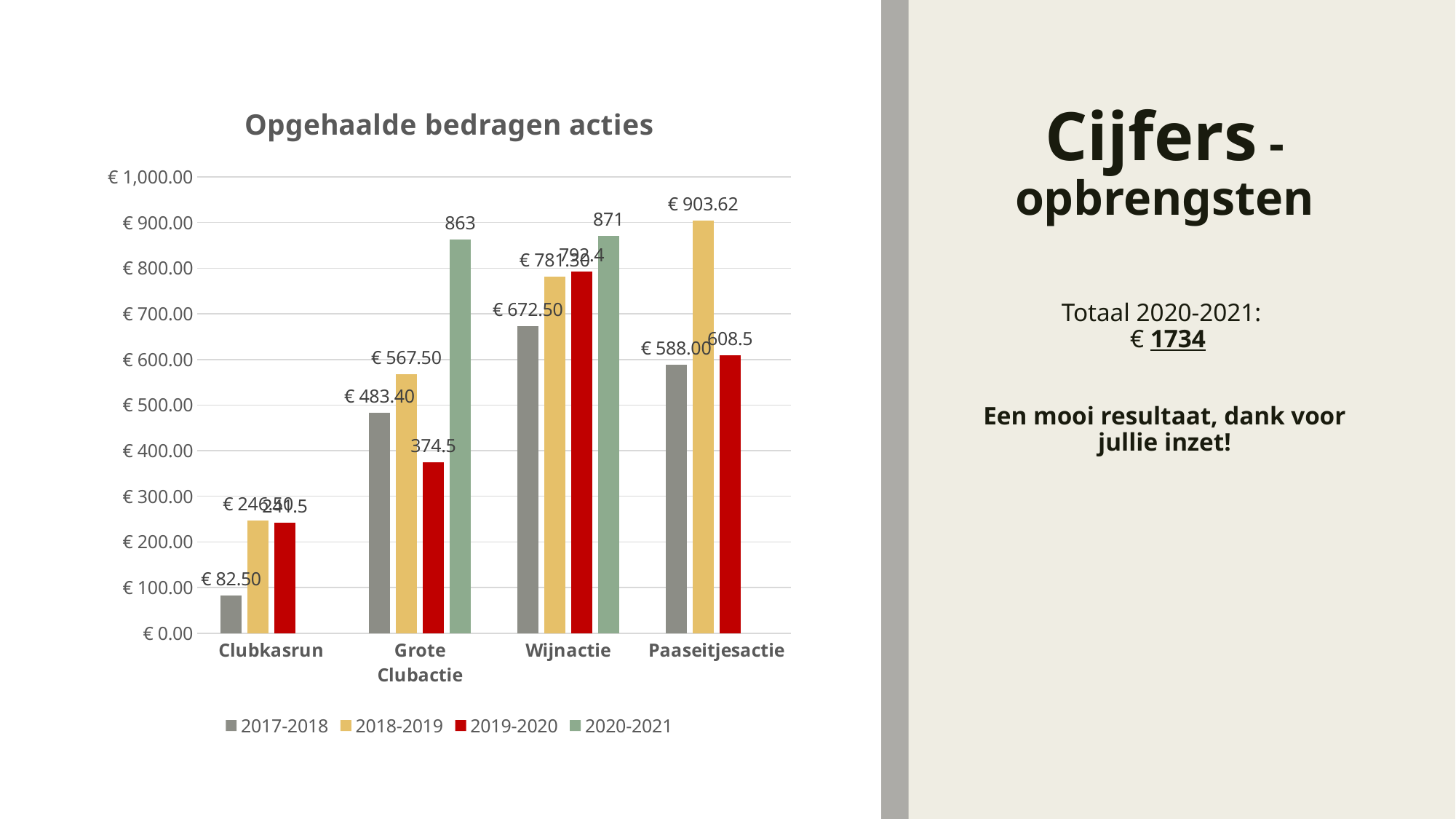
What is the title of the chart? Opgehaalde bedragen acties What is the value for Clubkasrun in 2017-2018? € 82.50 What is the value for Paaseitjesactie in 2018-2019? € 903.62 What is the value for Grote Clubactie in 2020-2021? 863 For Paaseitjesactie, which is larger: the 2017-2018 value or the 2019-2020 value? 2019-2020 What is the difference between the 2018-2019 and 2019-2020 values for Grote Clubactie? 193 Which category has the highest value for the 2020-2021 series? Wijnactie How many series does the legend list? 4 What kind of chart is shown on the slide? bar chart How many categories are shown on the x axis? 4 Which category has the lowest value for the 2017-2018 series? Clubkasrun Is the value for Wijnactie in 2017-2018 greater or less than € 600.00? greater